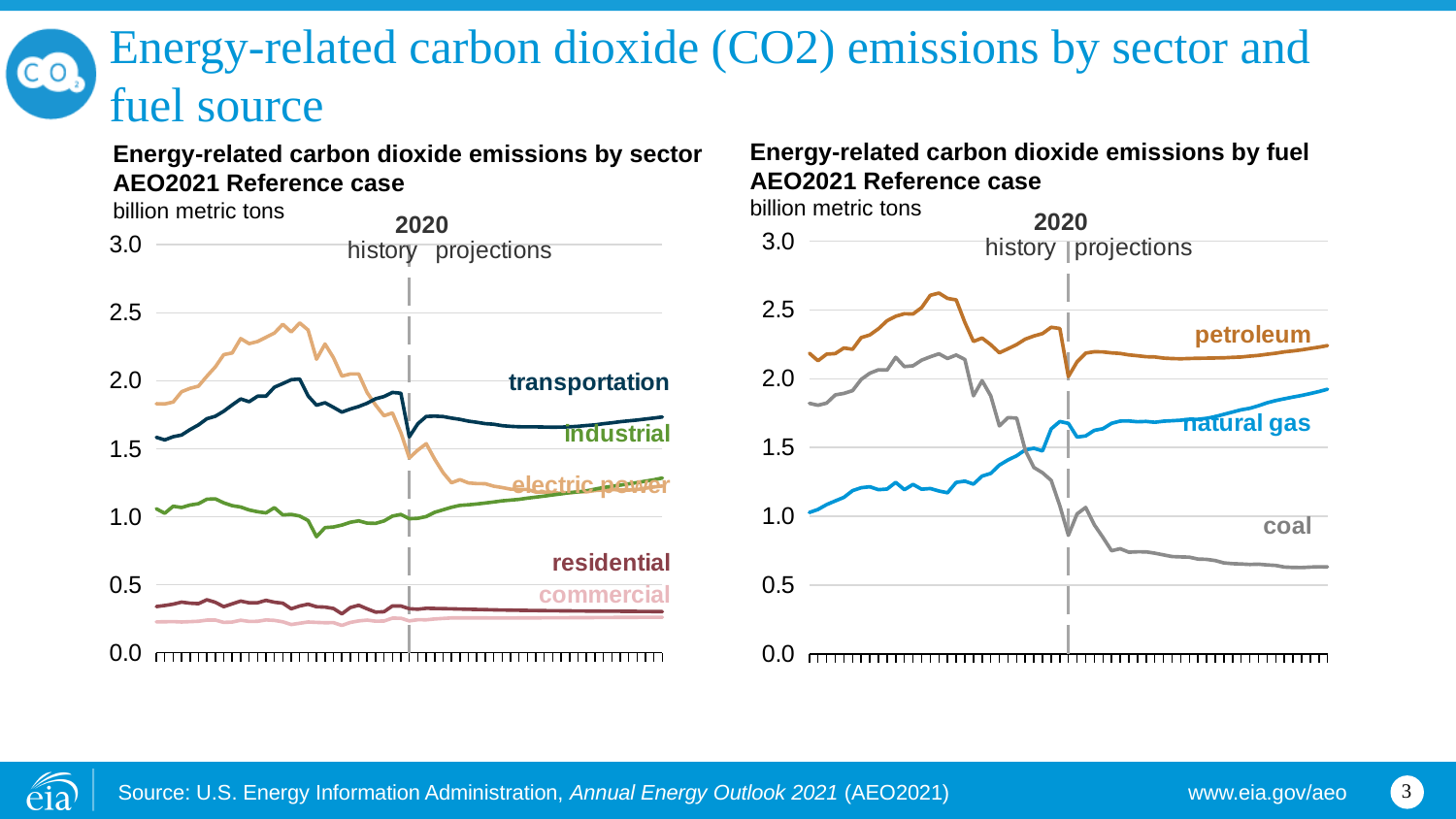
In the 'Energy-related carbon dioxide emissions by sector' chart, which sector has the lowest emissions at the end of the projection period? commercial How many series are plotted in the 'Energy-related carbon dioxide emissions by sector' chart on the left? 5 What type of chart is the 'Energy-related carbon dioxide emissions by sector' chart on the left? line chart How many series are plotted in the 'Energy-related carbon dioxide emissions by fuel' chart on the right? 3 In the 'Energy-related carbon dioxide emissions by fuel' chart, is the value for coal at the end of the projection period greater or less than 1.0 billion metric tons? less In the 'Energy-related carbon dioxide emissions by sector' chart, which sector has the highest emissions at the end of the projection period? transportation What unit is used on the y axis of both charts? billion metric tons In the 'Energy-related carbon dioxide emissions by fuel' chart, do coal emissions rise or fall over the period shown? fall In the 'Energy-related carbon dioxide emissions by fuel' chart, which fuel has the highest emissions at the end of the projection period? petroleum In the 'Energy-related carbon dioxide emissions by fuel' chart, is the value for petroleum at the end of the projection period greater or less than 2.0 billion metric tons? greater In the 'Energy-related carbon dioxide emissions by fuel' chart, which fuel has the lowest emissions at the end of the projection period? coal In the 'Energy-related carbon dioxide emissions by fuel' chart, do natural gas emissions rise or fall over the period shown? rise